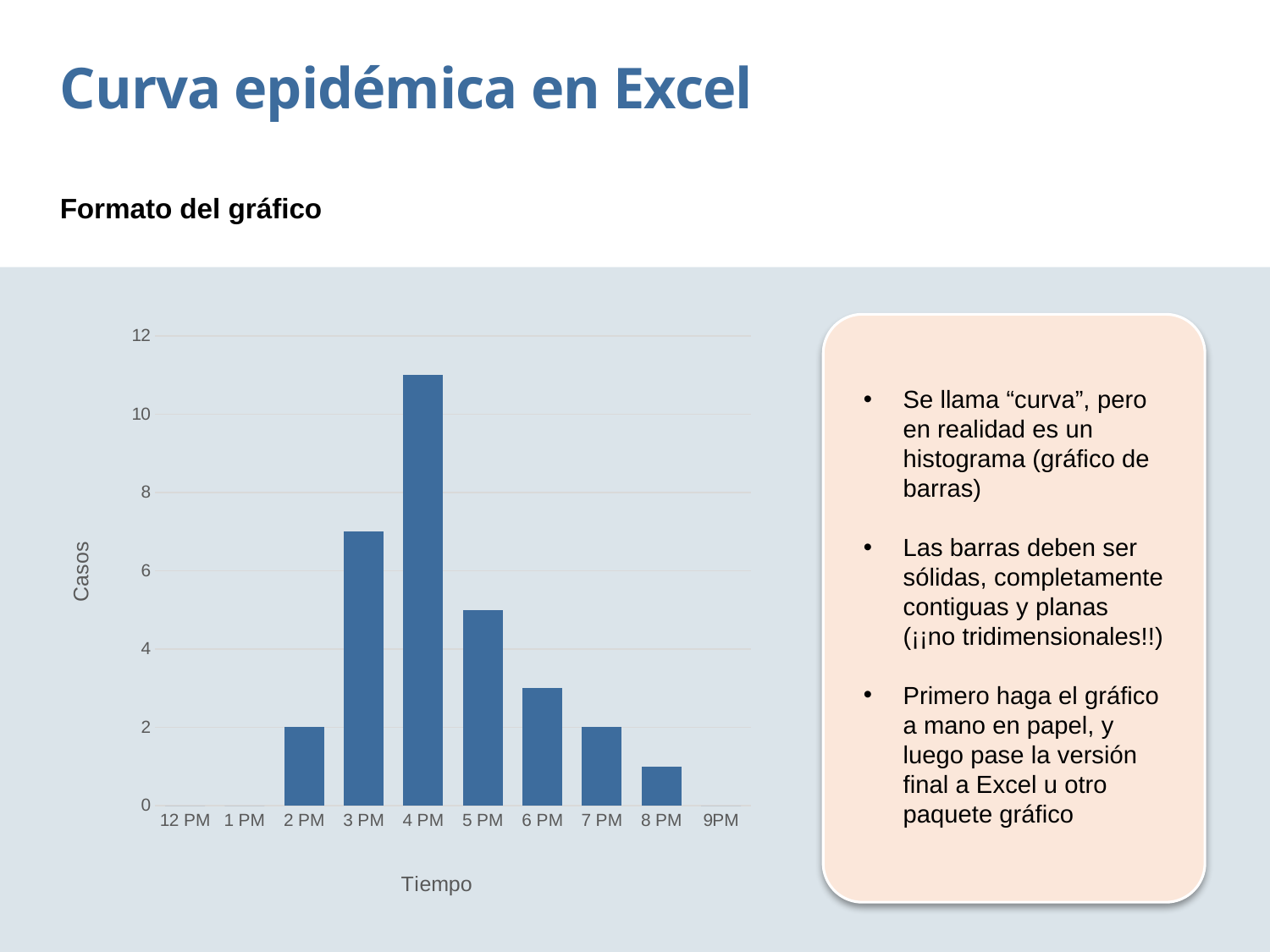
Is the value for 8 PM greater or less than 2? less Is the value for 5 PM greater or less than 6? less Which time has the highest number of cases? 4 PM What kind of chart is shown on the slide? bar chart How many cases are shown for 7 PM? 2 Is the value for 4 PM greater or less than 10? greater How many time categories are labelled on the x axis? 10 Among the times with a visible bar, which has the fewest cases? 8 PM What is the title of the vertical axis? Casos Which has more cases, 3 PM or 5 PM? 3 PM How many cases are shown for 2 PM? 2